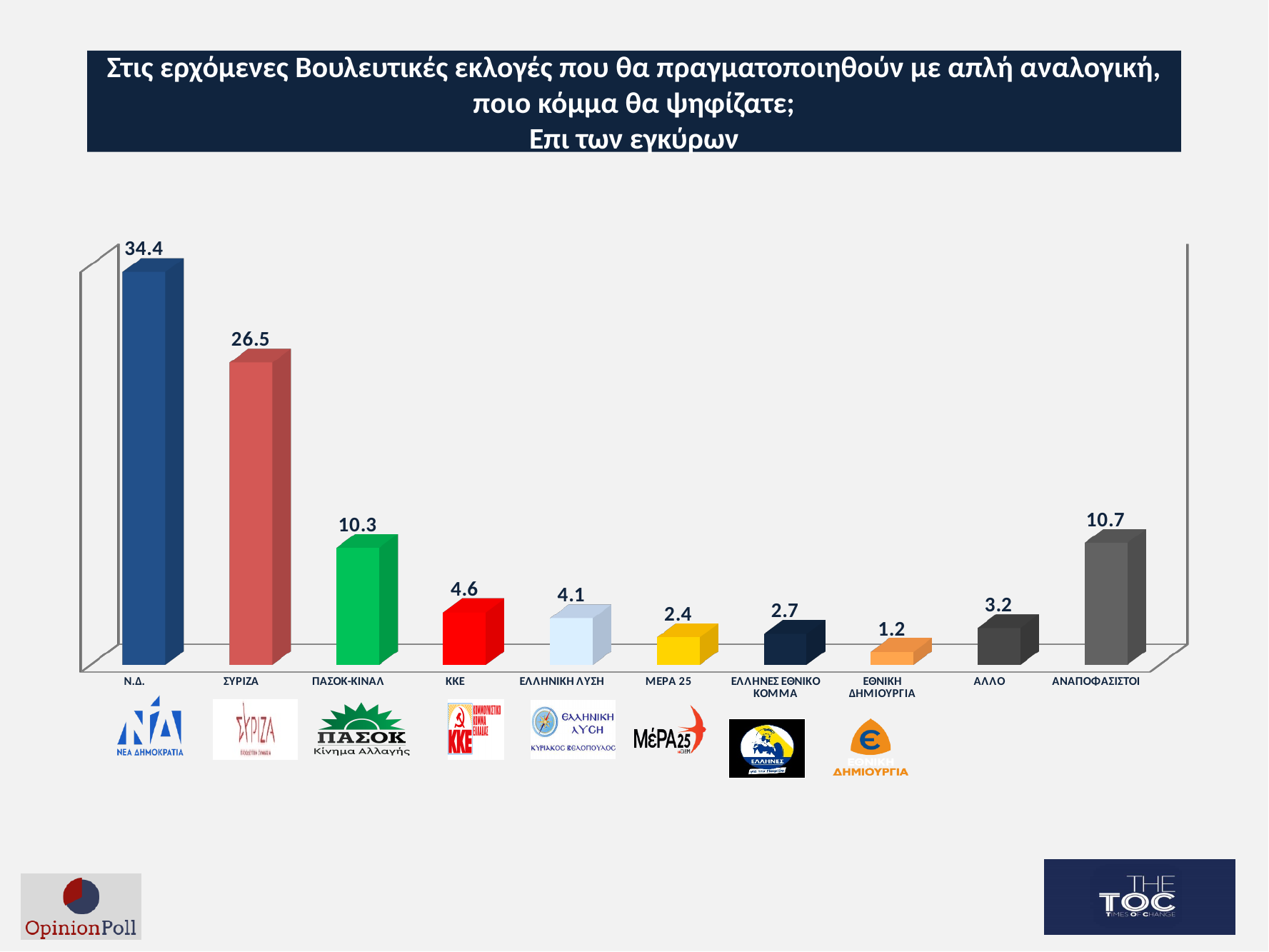
Which category has the highest value? Ν.Δ. What colour is the bar for ΠΑΣΟΚ-ΚΙΝΑΛ? green What is the value for ΠΑΣΟΚ-ΚΙΝΑΛ? 10.3 What kind of chart is shown on the slide? bar chart What is the difference between the values for Ν.Δ. and ΣΥΡΙΖΑ? 7.9 Which is larger, the value for ΚΚΕ or the value for ΕΛΛΗΝΙΚΗ ΛΥΣΗ? ΚΚΕ What is the value for ΣΥΡΙΖΑ? 26.5 What is the value for ΑΝΑΠΟΦΑΣΙΣΤΟΙ? 10.7 Which category has the lowest value? ΕΘΝΙΚΗ ΔΗΜΙΟΥΡΓΙΑ What is the value for Ν.Δ.? 34.4 How many categories are shown in the chart? 10 What is the value for ΕΘΝΙΚΗ ΔΗΜΙΟΥΡΓΙΑ? 1.2